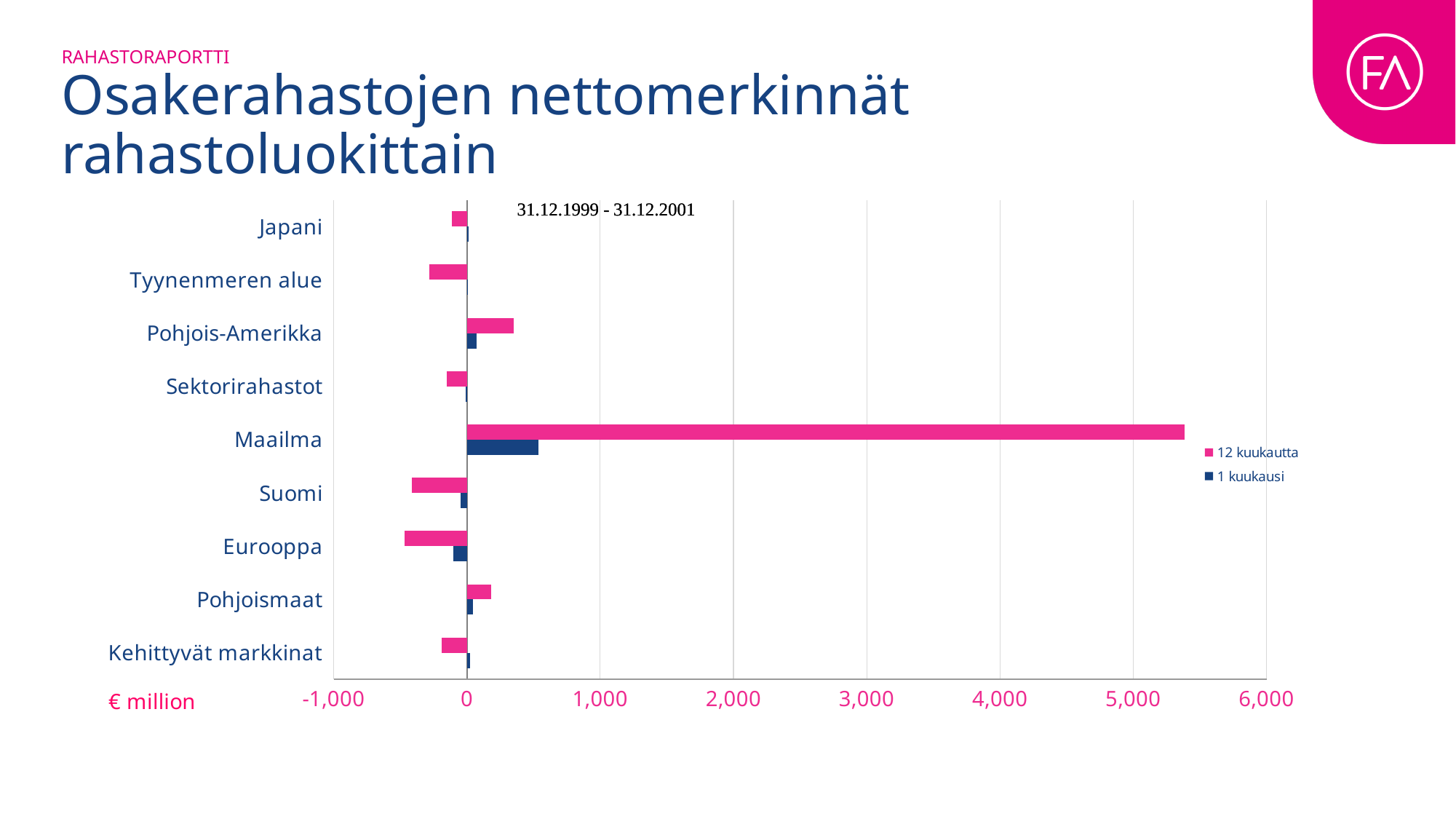
Which category has the highest value for the 12 kuukautta series? Maailma How many series does the chart legend list? 2 What date range is printed on the chart? 31.12.1999 - 31.12.2001 Is the 1 kuukausi value for Maailma greater or less than 1,000? less What kind of chart is shown on the slide? Bar chart For Maailma, which series has the larger value, 12 kuukautta or 1 kuukausi? 12 kuukautta What unit is shown for the horizontal axis of the chart? € million Which has the larger 12 kuukautta value, Japani or Pohjoismaat? Pohjoismaat Is the 12 kuukautta value for Maailma greater or less than 5,000? greater How many fund categories are listed on the vertical axis of the chart? 9 Is the 12 kuukautta value for Pohjois-Amerikka greater or less than 1,000? less Which has the larger 12 kuukautta value, Pohjois-Amerikka or Pohjoismaat? Pohjois-Amerikka